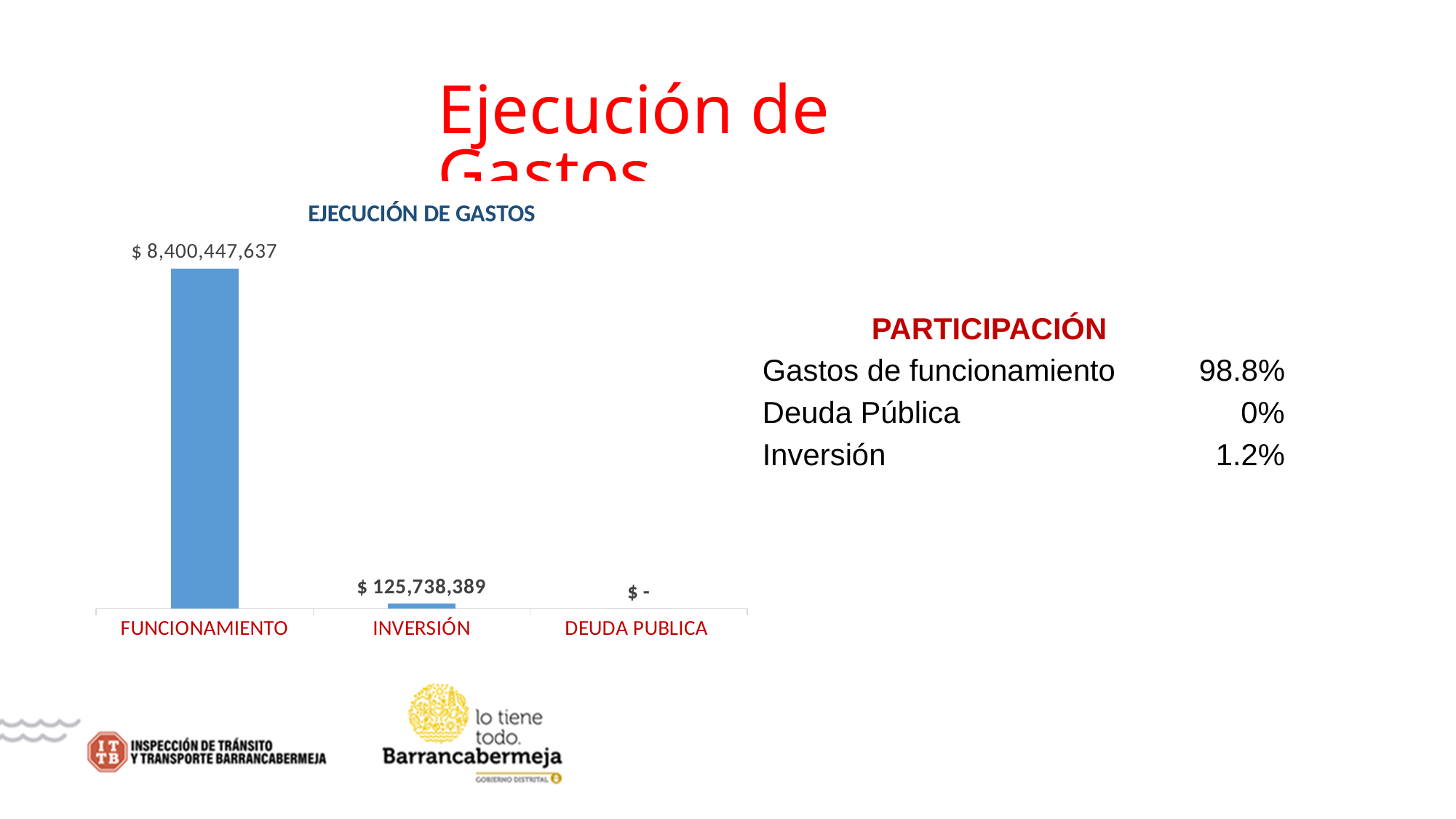
What is the value for INVERSIÓN? $ 125,738,389 What colour are the bars in the chart? Blue What is the data label shown for DEUDA PUBLICA? $ - What is the difference between the values for FUNCIONAMIENTO and INVERSIÓN? $ 8,274,709,248 Which category has the highest value? FUNCIONAMIENTO Which is larger, the value for INVERSIÓN or the value for DEUDA PUBLICA? INVERSIÓN Do the values rise or fall from left to right across the categories? Fall What is the title of the chart? EJECUCIÓN DE GASTOS What kind of chart is shown on the slide? Bar chart What is the value for FUNCIONAMIENTO? $ 8,400,447,637 How many categories are shown in the chart? 3 Which category has the lowest value? DEUDA PUBLICA